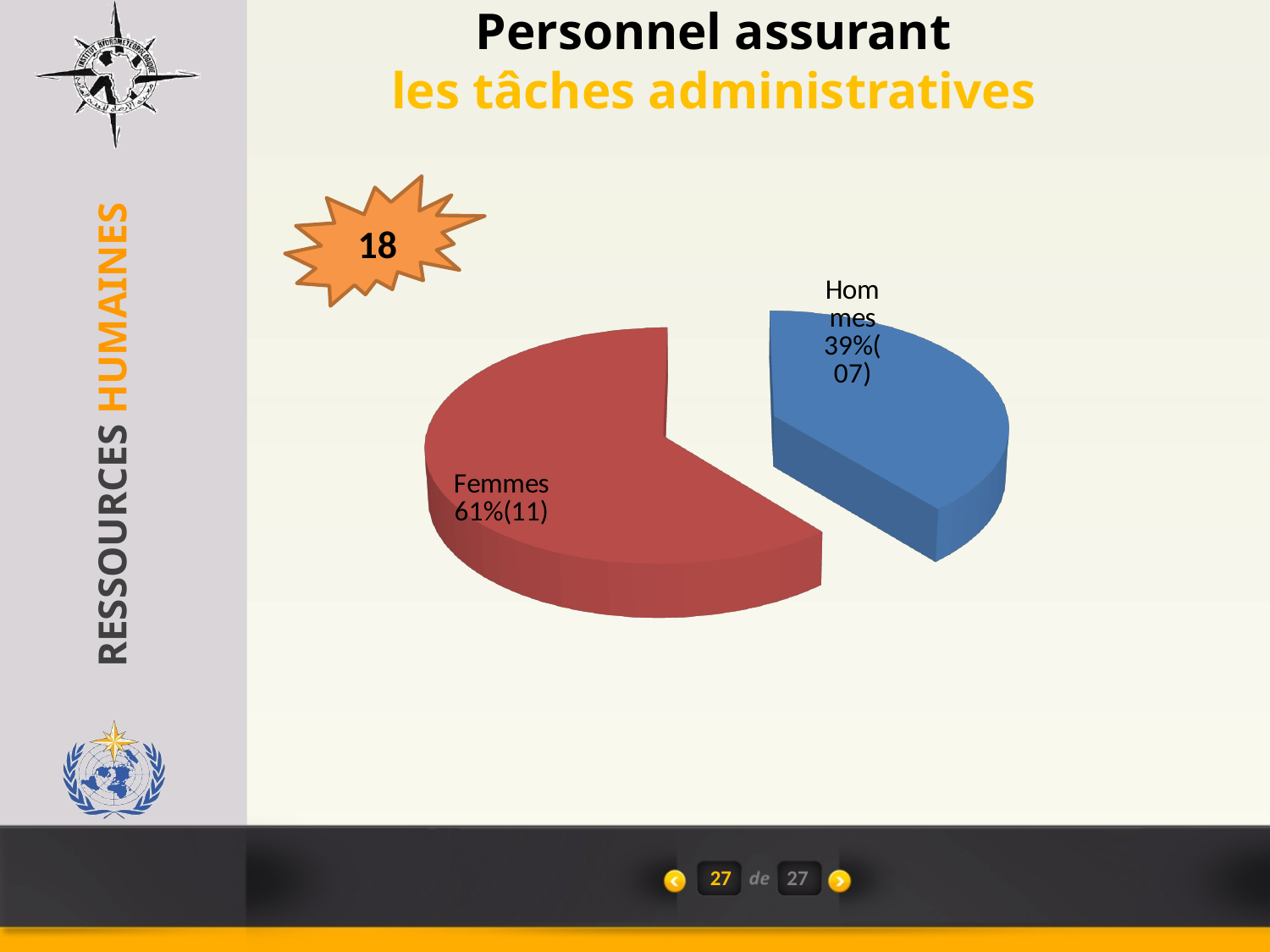
Which is larger in the pie chart, Femmes or Hommes? Femmes What percentage of the pie does the Femmes slice represent? 61% What colour is the Femmes slice of the pie chart? red What is the count shown for Hommes in the pie chart? 07 What kind of chart is shown on the slide? pie chart Which slice of the pie chart is the smallest? Hommes How many slices does the pie chart have? 2 What is the count shown for Femmes in the pie chart? 11 What percentage of the pie does the Hommes slice represent? 39% What is the difference in percentage points between the Femmes and Hommes slices? 22 Which slice of the pie chart is the largest? Femmes What colour is the Hommes slice of the pie chart? blue